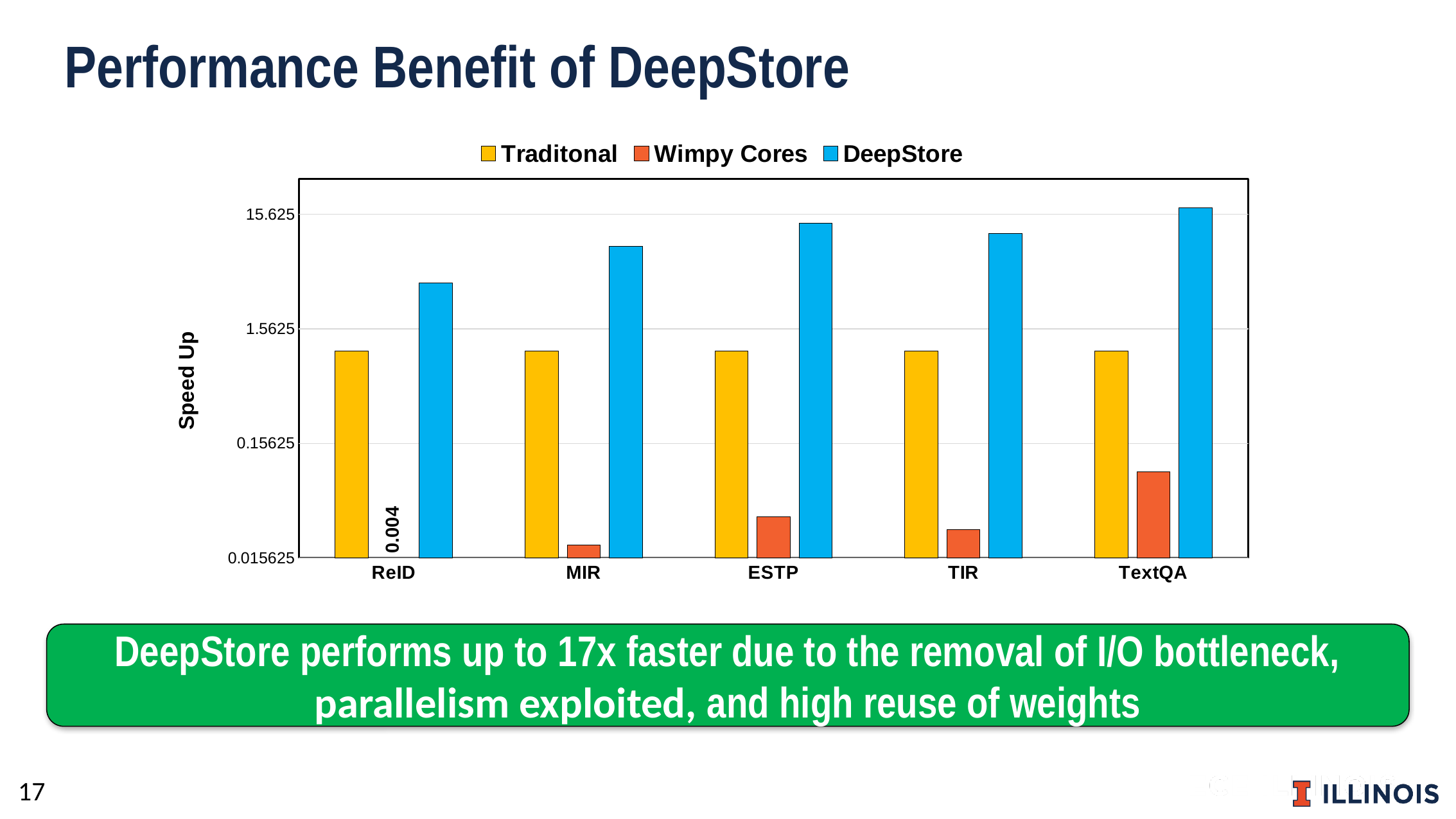
Which is larger for ESTP, the DeepStore speed up or the Traditional speed up? DeepStore Is the DeepStore speed up for ReID greater or less than 15.625? less Is the Wimpy Cores speed up for TextQA greater or less than 0.15625? less For which category is the DeepStore speed up highest? TextQA What is the label of the y axis? Speed Up What is the Speed Up value for Wimpy Cores on ReID? 0.004 For which category is the DeepStore speed up lowest? ReID How many series does the legend list? 3 For which category is the Wimpy Cores speed up highest? TextQA What kind of chart is shown on the slide? bar chart Is the Traditional speed up for MIR greater or less than 1.5625? less How many categories are shown on the x axis? 5